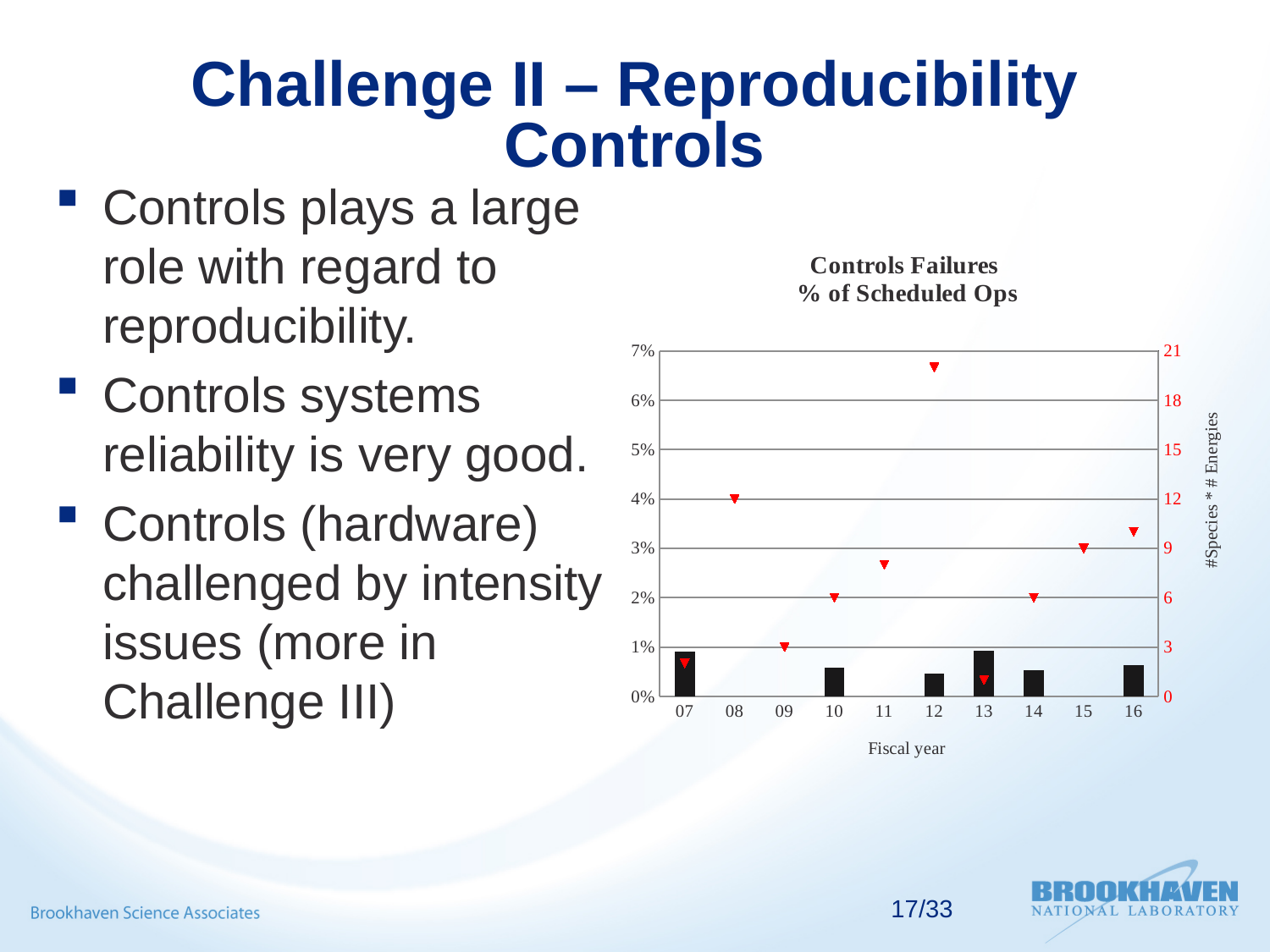
Is the bar value for fiscal year 12 greater or less than 1%? less What kind of chart is this? bar chart with point markers Which has the larger red marker value, fiscal year 08 or fiscal year 09? 08 Is the red marker value for fiscal year 12 greater or less than 18 on the right axis? greater Is the red marker value for fiscal year 11 greater or less than 6 on the right axis? greater What is the title of the chart? Controls Failures % of Scheduled Ops Which fiscal year has the highest red marker (#Species * # Energies)? 12 How many fiscal years are shown on the x axis? 10 Which has the taller bar, fiscal year 13 or fiscal year 14? 13 What is the label of the x axis? Fiscal year Which fiscal years show no bar at all? 08, 09, 11, 15